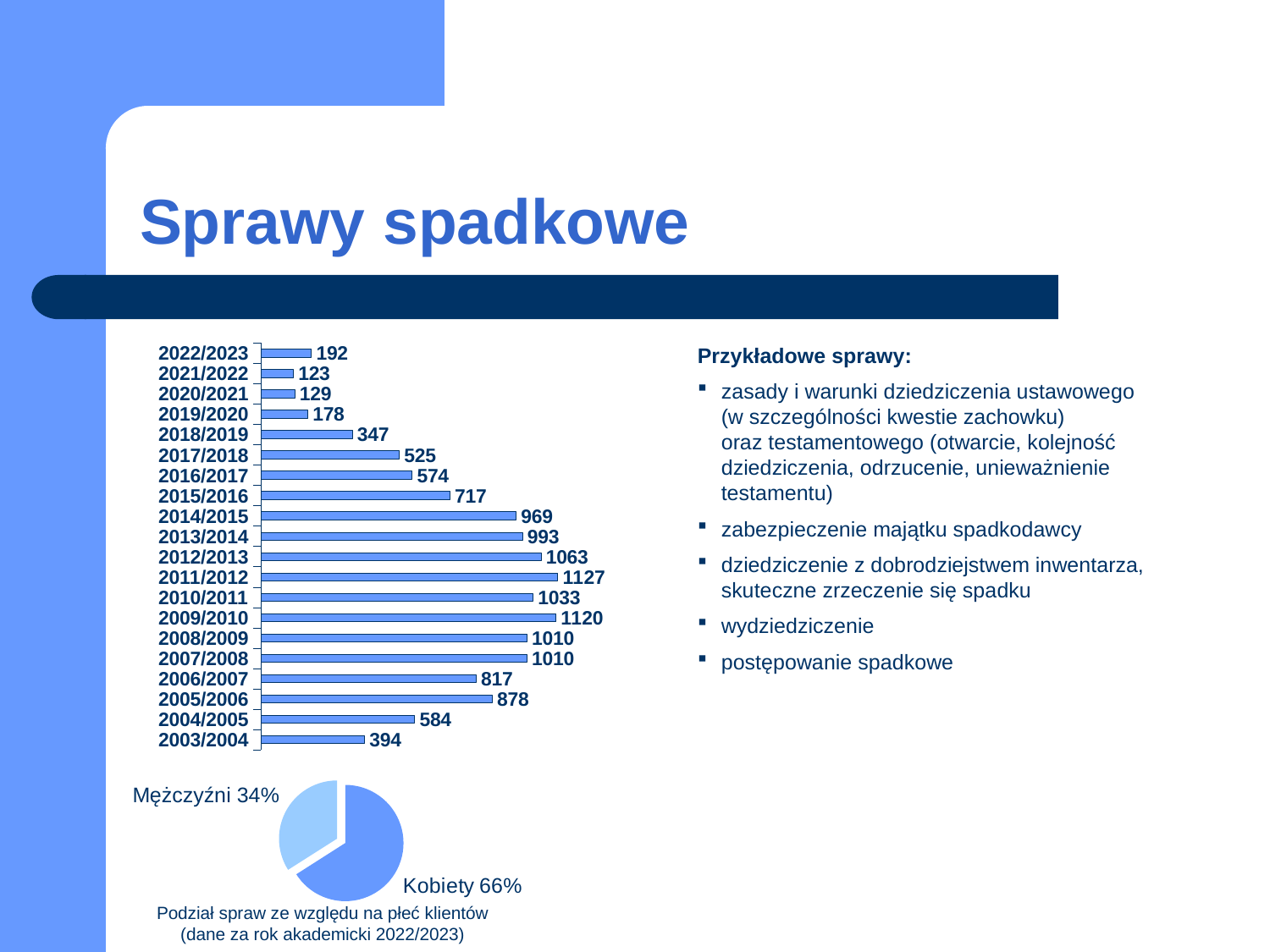
In the bar chart at the top left, which is larger, the value for 2013/2014 or the value for 2014/2015? 2013/2014 In the bar chart at the top left, what is the difference between the values for 2005/2006 and 2006/2007? 61 What kind of chart is the chart at the bottom left of the slide? pie chart In the bar chart at the top left, what is the value for 2003/2004? 394 In the bar chart at the top left, how many academic years are shown? 20 What kind of chart is the chart at the top left of the slide? bar chart In the pie chart at the bottom left, what share is labelled Kobiety? 66% In the bar chart at the top left, which academic year has the lowest value? 2021/2022 In the bar chart at the top left, which academic year has the highest value? 2011/2012 In the pie chart at the bottom left, what share is labelled Mężczyźni? 34% In the bar chart at the top left, what is the value for 2017/2018? 525 In the bar chart at the top left, what is the difference between the values for 2009/2010 and 2022/2023? 928